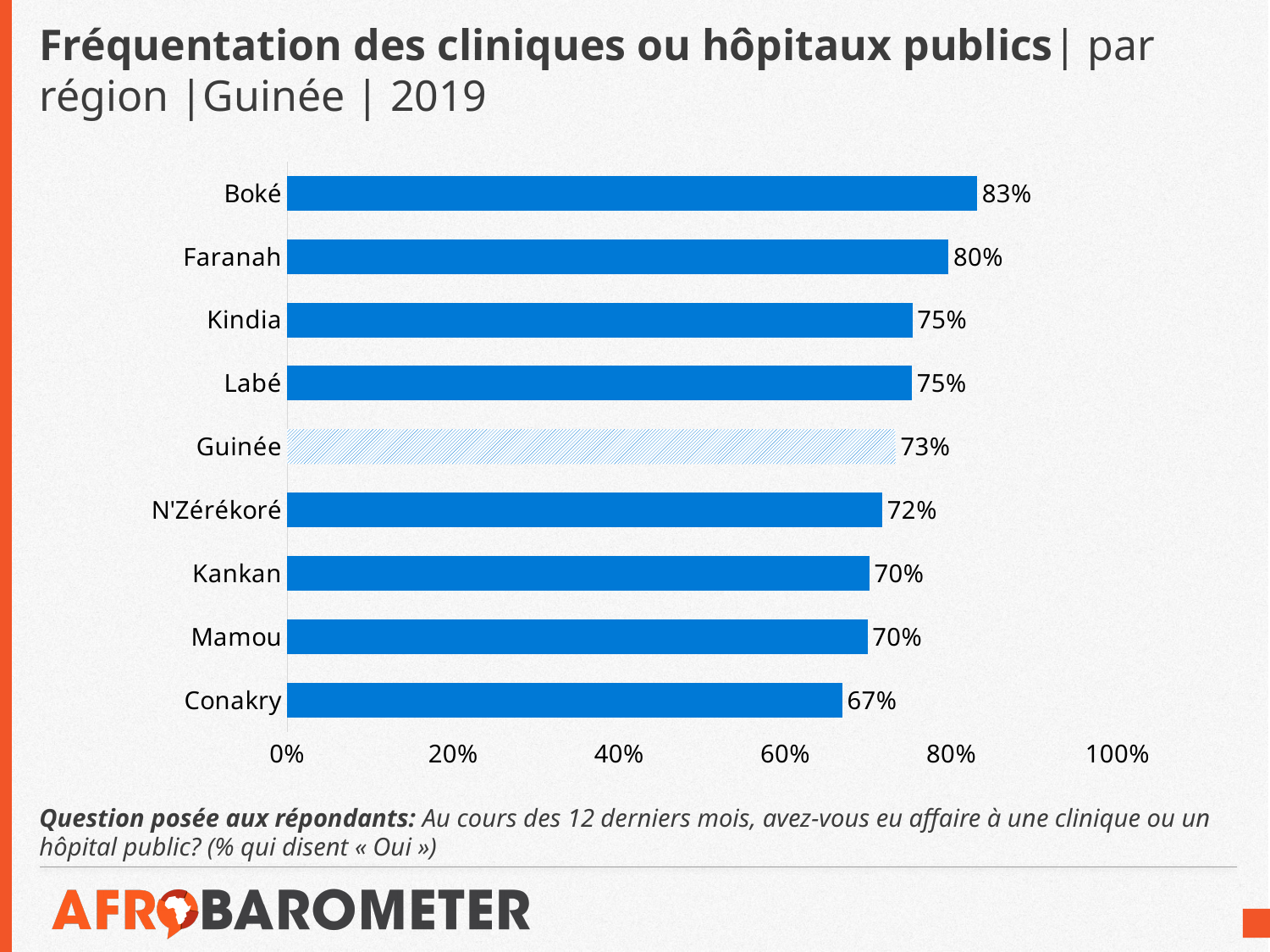
What is the value for Conakry? 67% What is the difference between the values for Faranah and Kankan? 10 percentage points What is the value for Guinée overall? 73% What is the value for N'Zérékoré? 72% What is the difference between the values for Boké and Conakry? 16 percentage points Which is larger, the value for Kindia or the value for Mamou? Kindia Which region has the lowest value? Conakry Is the value for Faranah greater or less than 60%? greater What kind of chart is shown on the slide? Bar chart How many bars are shown in the chart? 9 What is the value for Boké? 83% Which region has the highest value? Boké